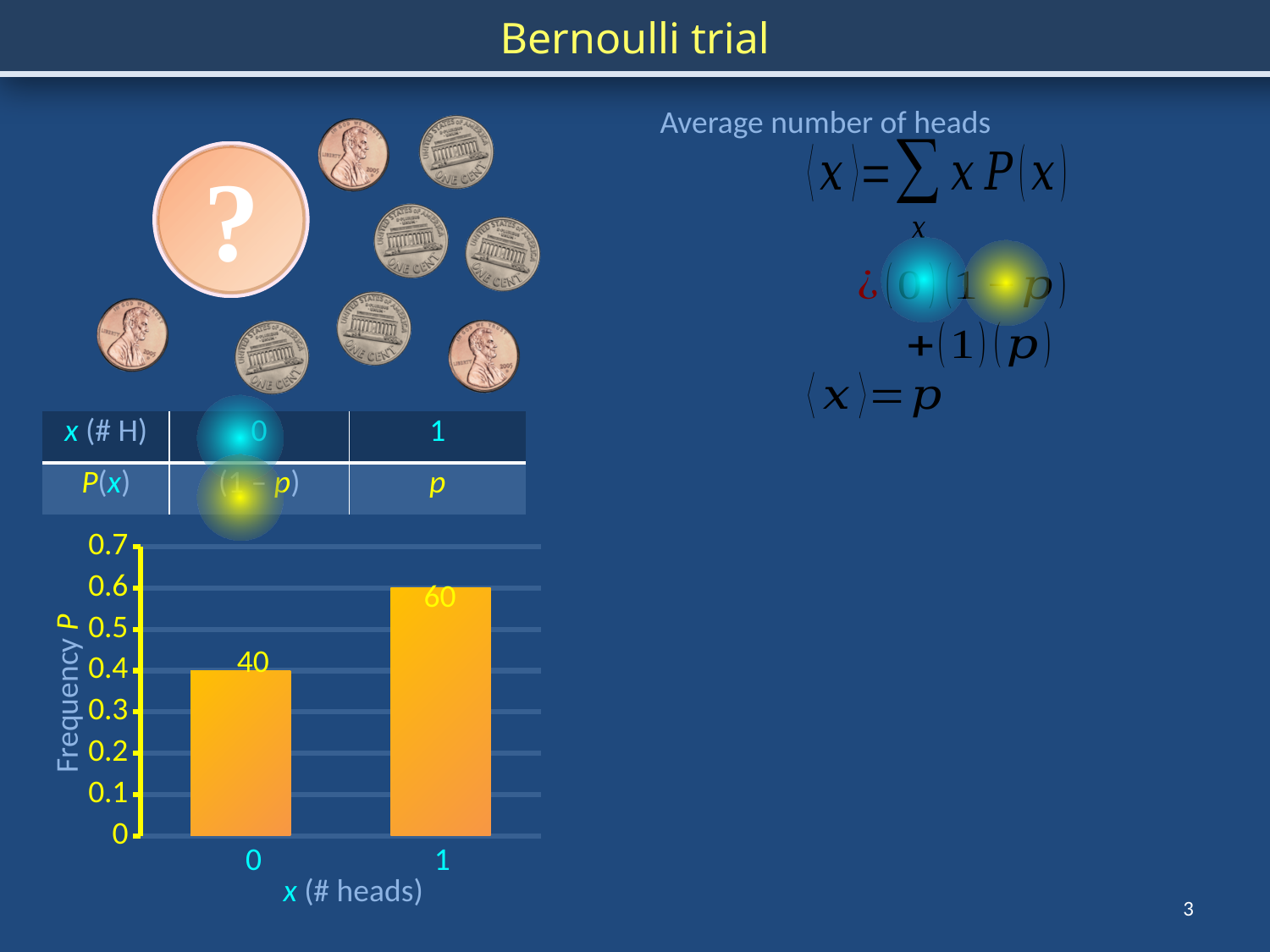
How many bars does the chart have? 2 What kind of chart is shown on the slide? bar chart What data label is printed on the bar for x = 0? 40 Which x value has the shorter bar? 0 Is the bar for x = 1 greater or less than 0.5 on the Frequency P axis? greater Which x value has the taller bar? 1 What is the difference between the data labels on the bars for x = 1 and x = 0? 20 What data label is printed on the bar for x = 1? 60 Is the bar for x = 0 taller or shorter than the bar for x = 1? shorter What is the title of the vertical axis of the chart? Frequency P Do the bar heights rise or fall from x = 0 to x = 1? rise Is the bar for x = 0 greater or less than 0.5 on the Frequency P axis? less